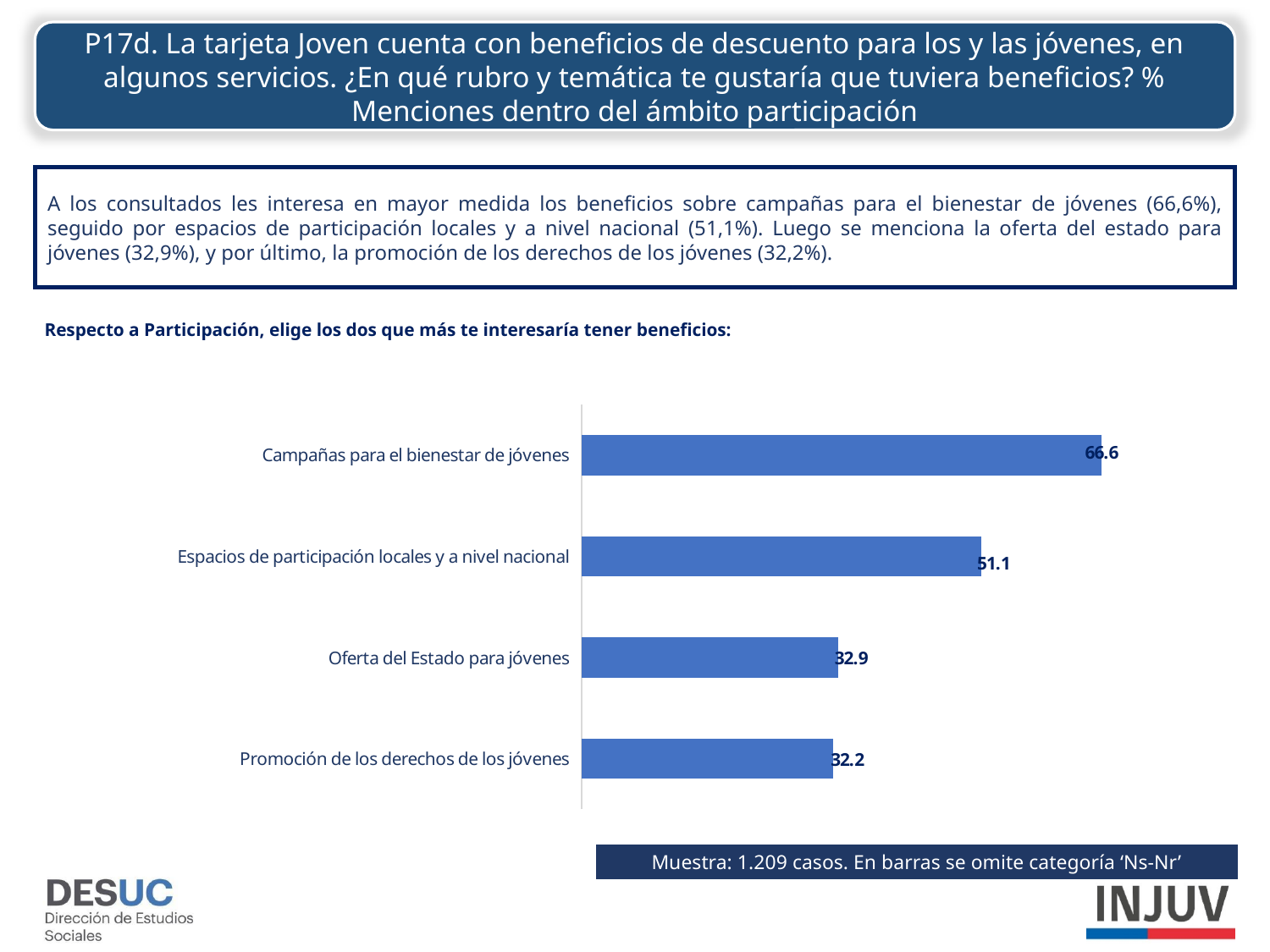
Which category has the highest value? Campañas para el bienestar de jóvenes What is the value for 'Promoción de los derechos de los jóvenes'? 32.2 How many categories are shown in the chart? 4 Which category has the lowest value? Promoción de los derechos de los jóvenes What is the value for 'Campañas para el bienestar de jóvenes'? 66.6 What is the difference between the values for 'Campañas para el bienestar de jóvenes' and 'Espacios de participación locales y a nivel nacional'? 15.5 What is the value for 'Oferta del Estado para jóvenes'? 32.9 What is the difference between the values for 'Oferta del Estado para jóvenes' and 'Promoción de los derechos de los jóvenes'? 0.7 What is the value for 'Espacios de participación locales y a nivel nacional'? 51.1 Which is larger: the value for 'Espacios de participación locales y a nivel nacional' or the value for 'Oferta del Estado para jóvenes'? Espacios de participación locales y a nivel nacional What kind of chart is shown on the slide? Bar chart What is the sample size stated on the slide? 1.209 casos